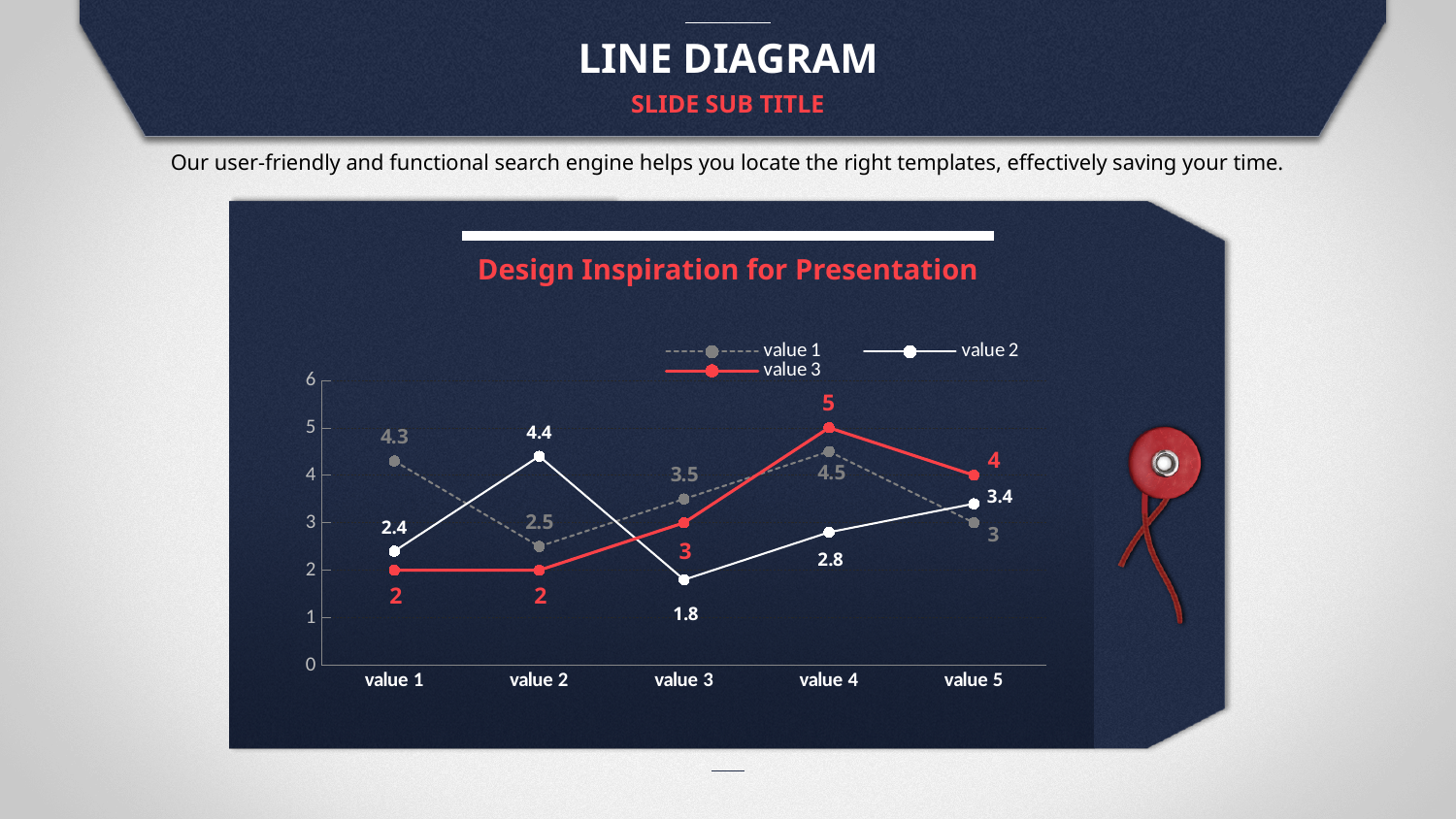
What is the difference between the 'value 1' and 'value 2' series at category 'value 1'? 1.9 At which category does the 'value 3' series reach its highest value? value 4 What is the value of the 'value 3' series at category 'value 5'? 4 What is the value of the 'value 2' series at category 'value 3'? 1.8 At which category does the 'value 2' series have its lowest value? value 3 What kind of chart is shown on the slide? line chart At category 'value 2', which series has the larger value, 'value 2' or 'value 3'? value 2 How many series does the legend list? 3 Does the 'value 3' series rise or fall from category 'value 2' to category 'value 4'? rise What is the value of the 'value 1' series at category 'value 4'? 4.5 How many categories are shown on the x axis? 5 What is the title of the chart? Design Inspiration for Presentation